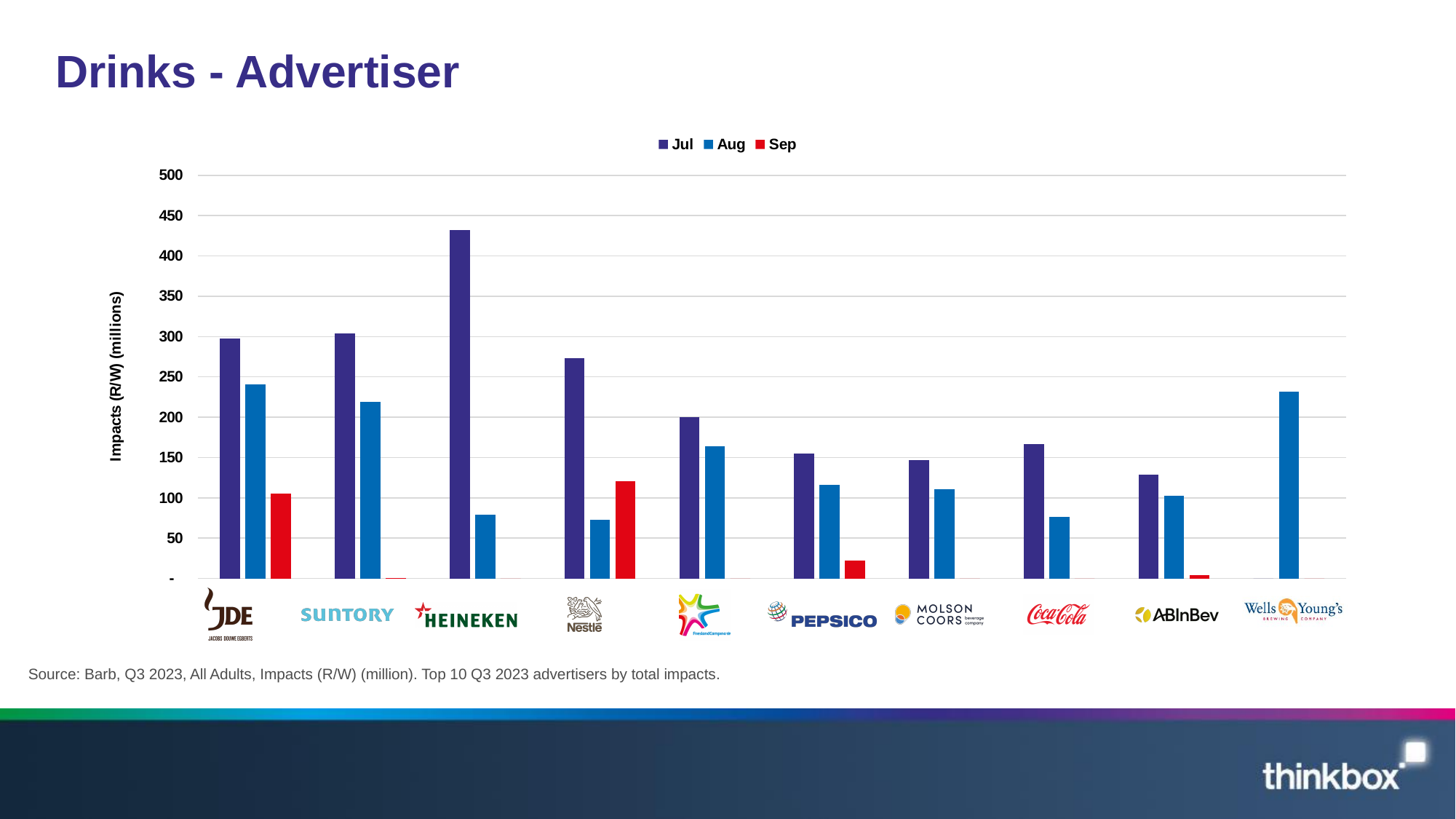
What kind of chart is shown on the slide? bar chart Is the Sep value for PepsiCo greater or less than 50? less Is the Jul value for Heineken greater or less than 400? greater How many advertisers are shown along the x axis? 10 What is the label on the y axis? Impacts (R/W) (millions) Is the Aug value for Wells & Young's greater or less than 200? greater Which advertiser has the lowest Jul value? Wells & Young's How many series does the legend list? 3 Which is larger for Coca-Cola, the Jul value or the Aug value? Jul Which advertiser has the highest Sep value? Nestlé Which advertiser has the highest Jul value? Heineken